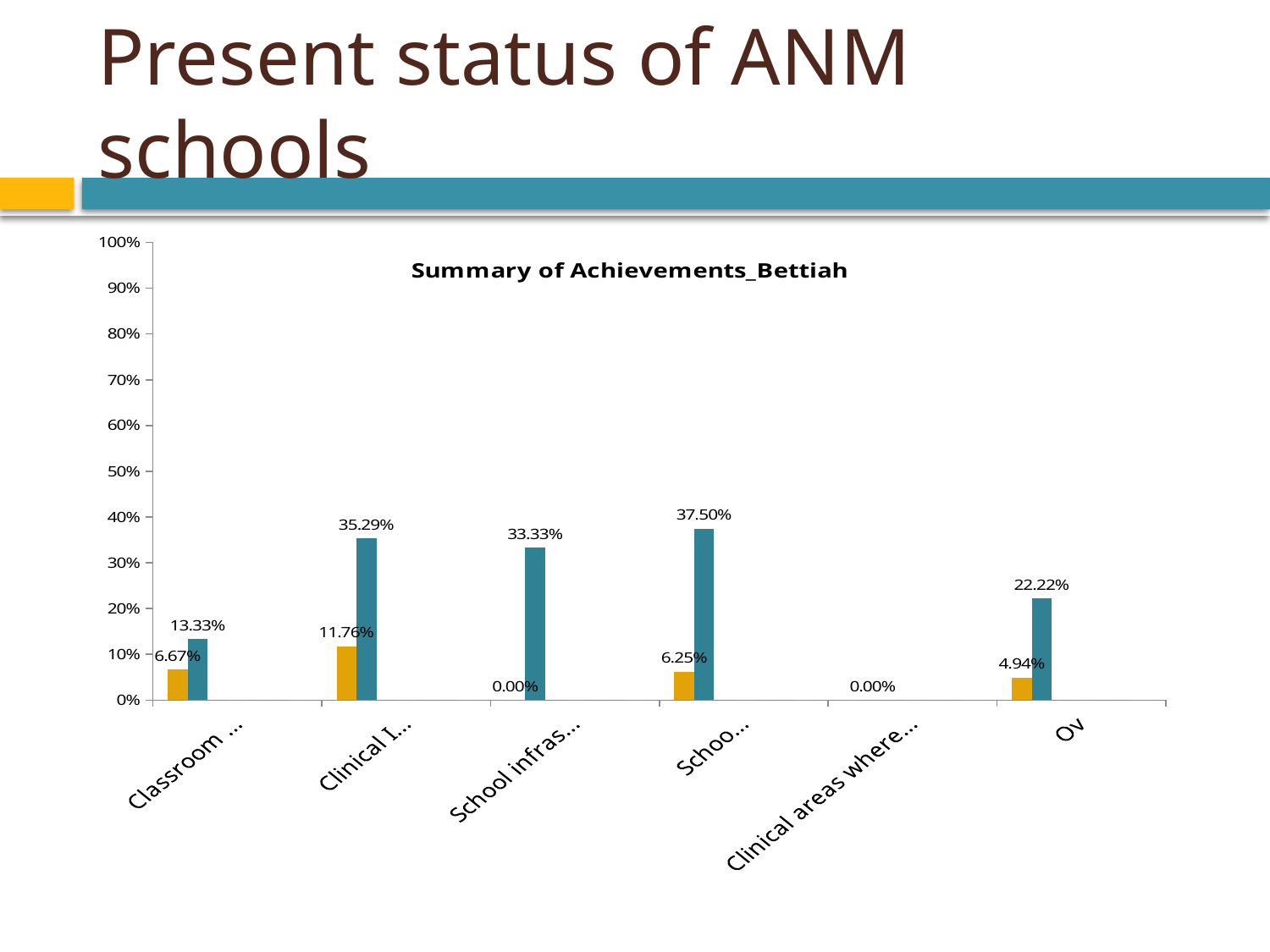
What is the difference between the teal bar and the orange bar for the second category from the left (Clinical I...)? 23.53% What is the title of the chart? Summary of Achievements_Bettiah What is the lowest value labelled for an orange bar in the chart? 0.00% What type of chart is shown on the slide? Bar chart Which is larger: the teal bar for the third category (School infras...) or the teal bar for the last category (Ov)? The teal bar for the third category (School infras...) What is the value of the orange bar for the first category from the left (Classroom ...)? 6.67% Is the value of the teal bar for the fourth category from the left (Schoo...) greater or less than 30%? greater What is the value of the orange bar for the last category on the right (Ov)? 4.94% What is the difference between the teal bar and the orange bar for the first category from the left (Classroom ...)? 6.66% What is the value of the teal bar for the second category from the left (Clinical I...)? 35.29% How many categories are shown along the x axis of the chart? 6 What is the highest value shown by any teal bar in the chart? 37.50%